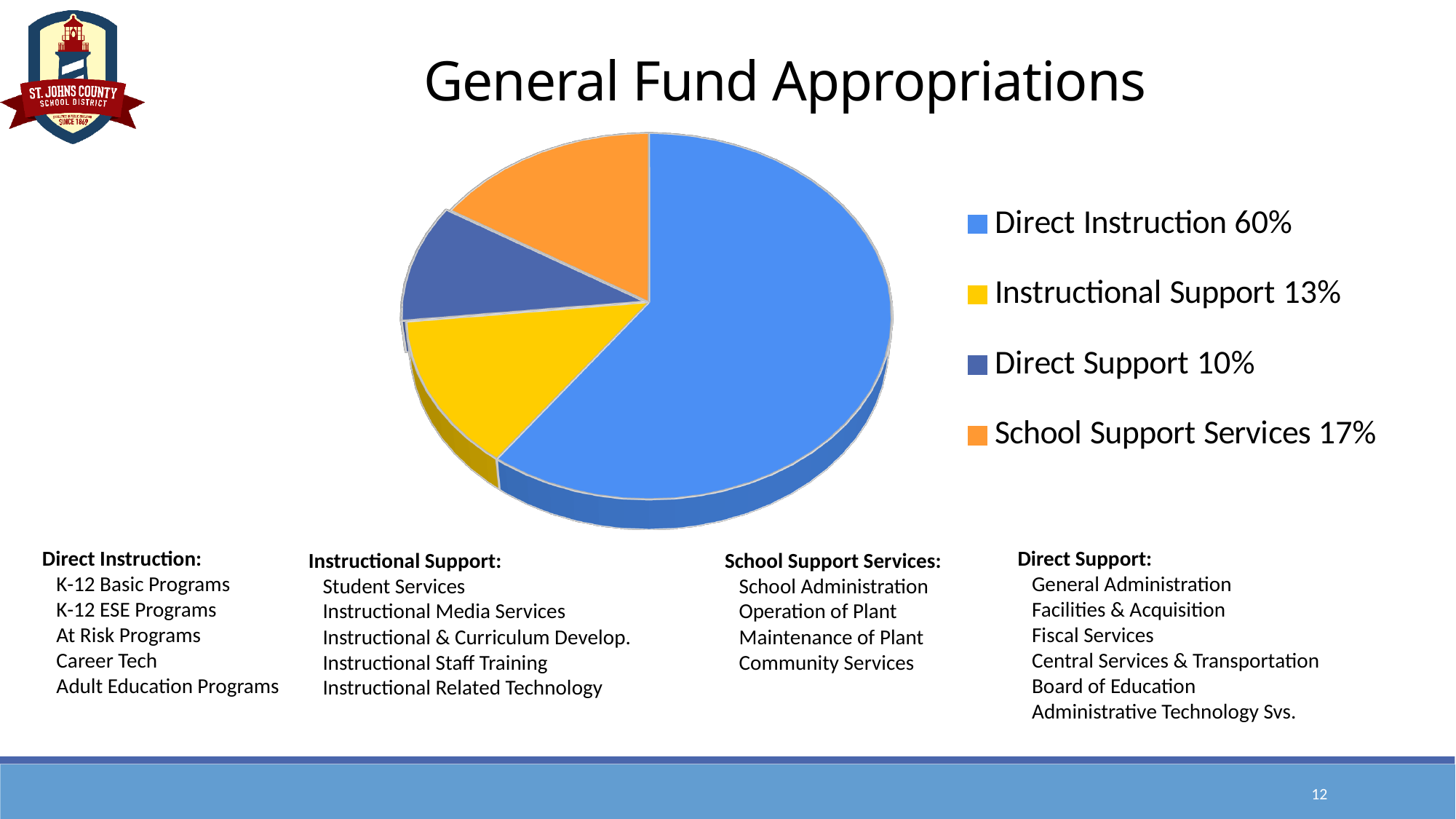
Which is larger, the share for School Support Services or the share for Instructional Support? School Support Services How many slices does the pie chart have? 4 What kind of chart is shown on the slide? pie chart What colour is the Instructional Support slice? yellow What share of General Fund Appropriations goes to Instructional Support? 13% What share of General Fund Appropriations goes to Direct Instruction? 60% What is the title of the chart? General Fund Appropriations What share of General Fund Appropriations goes to School Support Services? 17% Which category has the largest share of the pie? Direct Instruction Which category has the smallest share of the pie? Direct Support What is the difference in percentage points between Direct Instruction and School Support Services? 43